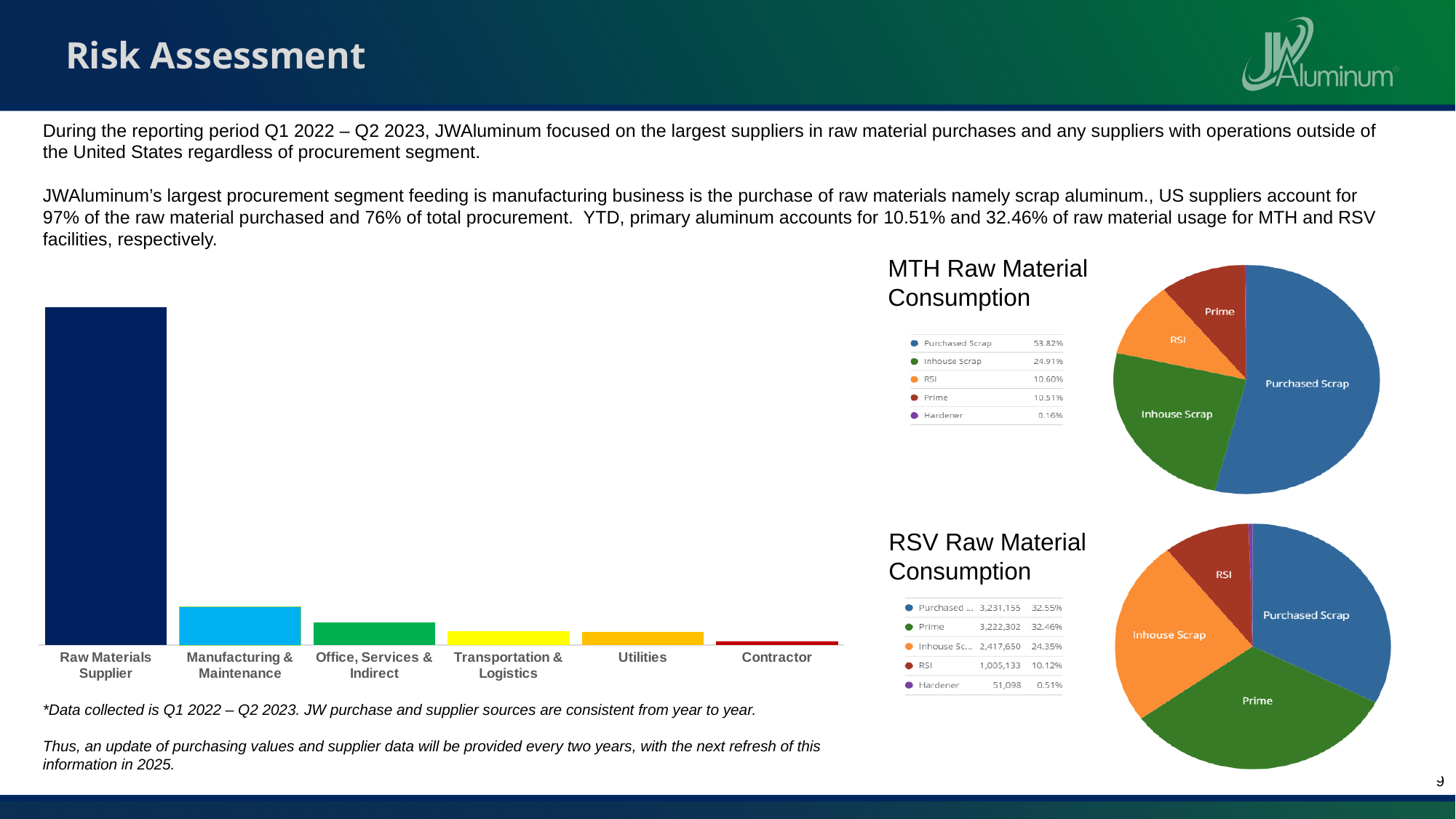
In the MTH Raw Material Consumption chart, what share is Inhouse Scrap? 24.91% In the MTH Raw Material Consumption chart, what share is Purchased Scrap? 53.82% In the bar chart on the left, which category has the tallest bar? Raw Materials Supplier In the RSV Raw Material Consumption chart, what is the value for Prime? 3,222,302 In the MTH Raw Material Consumption chart, how many categories does the legend list? 5 In the RSV Raw Material Consumption chart, what share is RSI? 10.12% In the bar chart on the left, which is larger: Manufacturing & Maintenance or Office, Services & Indirect? Manufacturing & Maintenance In the MTH Raw Material Consumption chart, which category has the smallest share? Hardener In the bar chart on the left, how many procurement segment categories are shown? 6 In the RSV Raw Material Consumption chart, what is the difference in percentage share between Inhouse Scrap and RSI? 14.23% What kind of chart is the chart on the left of the slide showing procurement segments? bar chart In the bar chart on the left, which category has the shortest bar? Contractor